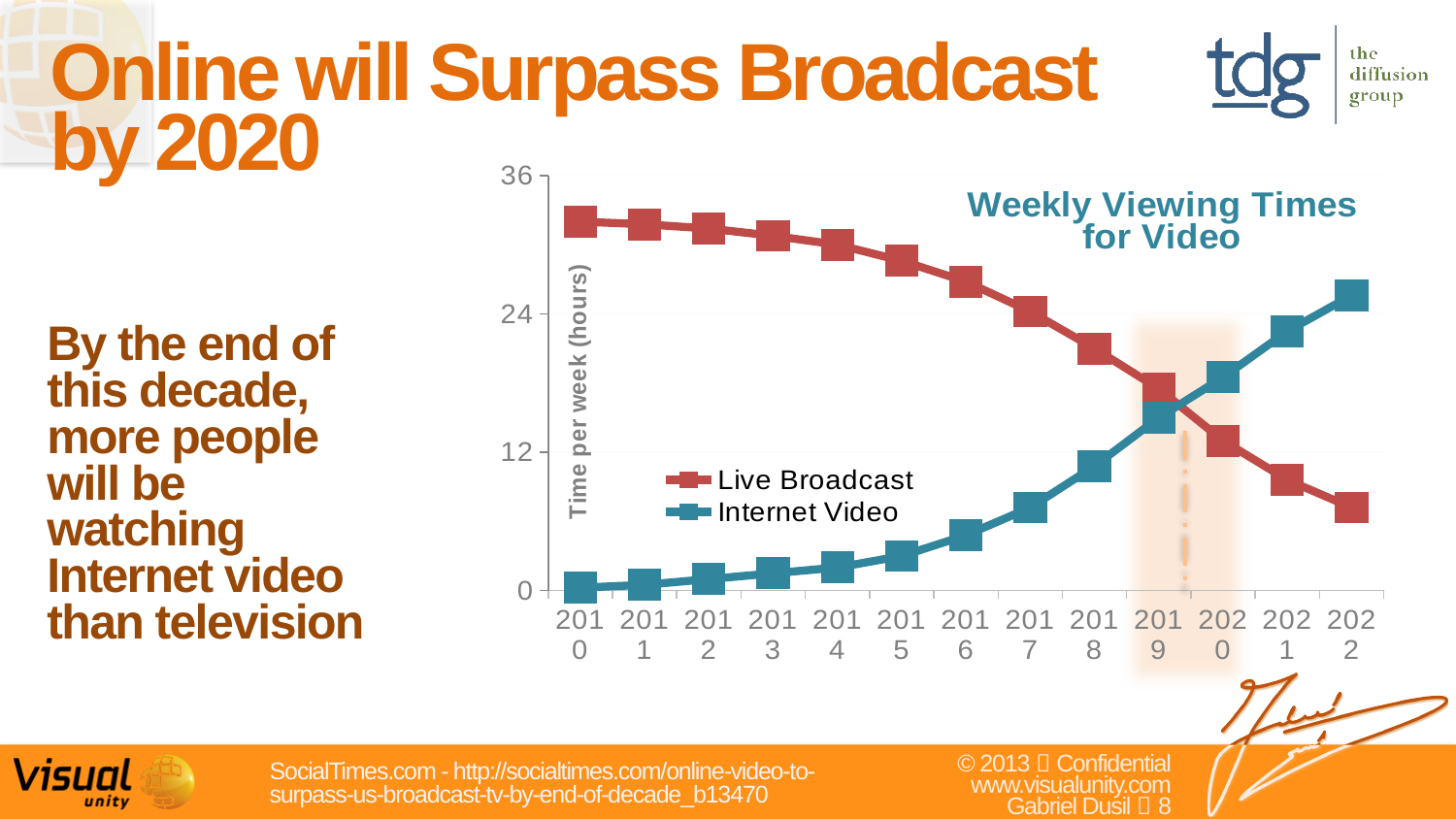
How many years are plotted along the x axis of the chart? 13 Does the Internet Video series rise or fall from 2010 to 2022? Rise What is the title of the chart? Weekly Viewing Times for Video What kind of chart is shown on the slide? Line chart How many series does the chart's legend list? 2 In which year does the Internet Video series reach its highest value? 2022 Is the Live Broadcast value for 2022 greater or less than 12? less In 2010, which series has the larger value, Live Broadcast or Internet Video? Live Broadcast Is the Live Broadcast value for 2010 greater or less than 24? greater Is the Internet Video value for 2010 greater or less than 12? less Does the Live Broadcast series rise or fall from 2010 to 2022? Fall What is the label on the chart's vertical axis? Time per week (hours)